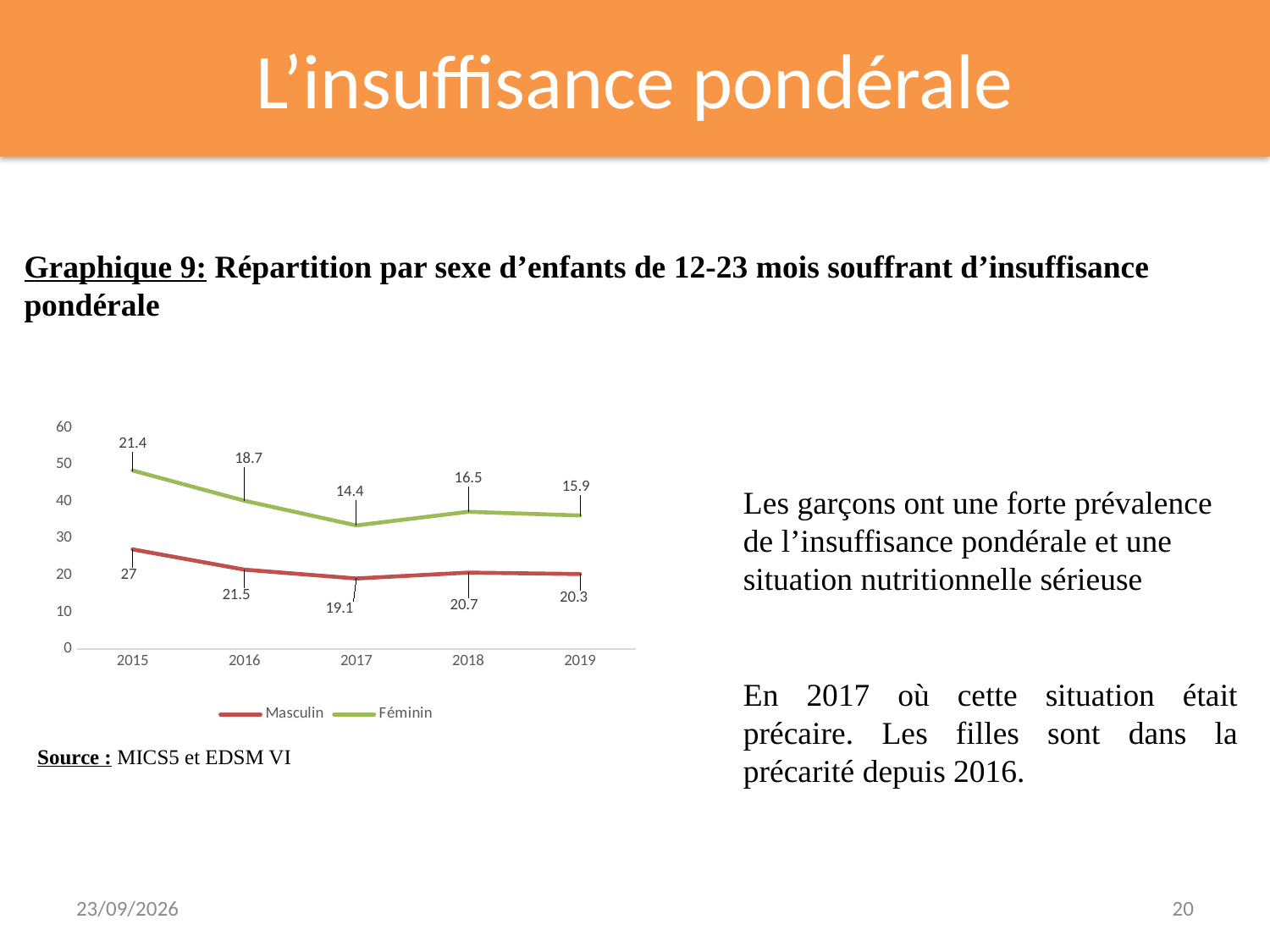
What is the value for Masculin in 2015? 27 Does the Féminin value rise or fall from 2015 to 2017? Fall What is the value for Féminin in 2017? 14.4 How many series does the legend list? 2 What kind of chart is shown on the slide? Line chart What is the difference between the Féminin values in 2015 and 2019? 5.5 What is the value for Masculin in 2019? 20.3 How many years are shown on the x axis? 5 What is the difference between the Masculin values in 2015 and 2016? 5.5 In which year is the Féminin value lowest? 2017 What is the value for Féminin in 2018? 16.5 In which year is the Masculin value highest? 2015